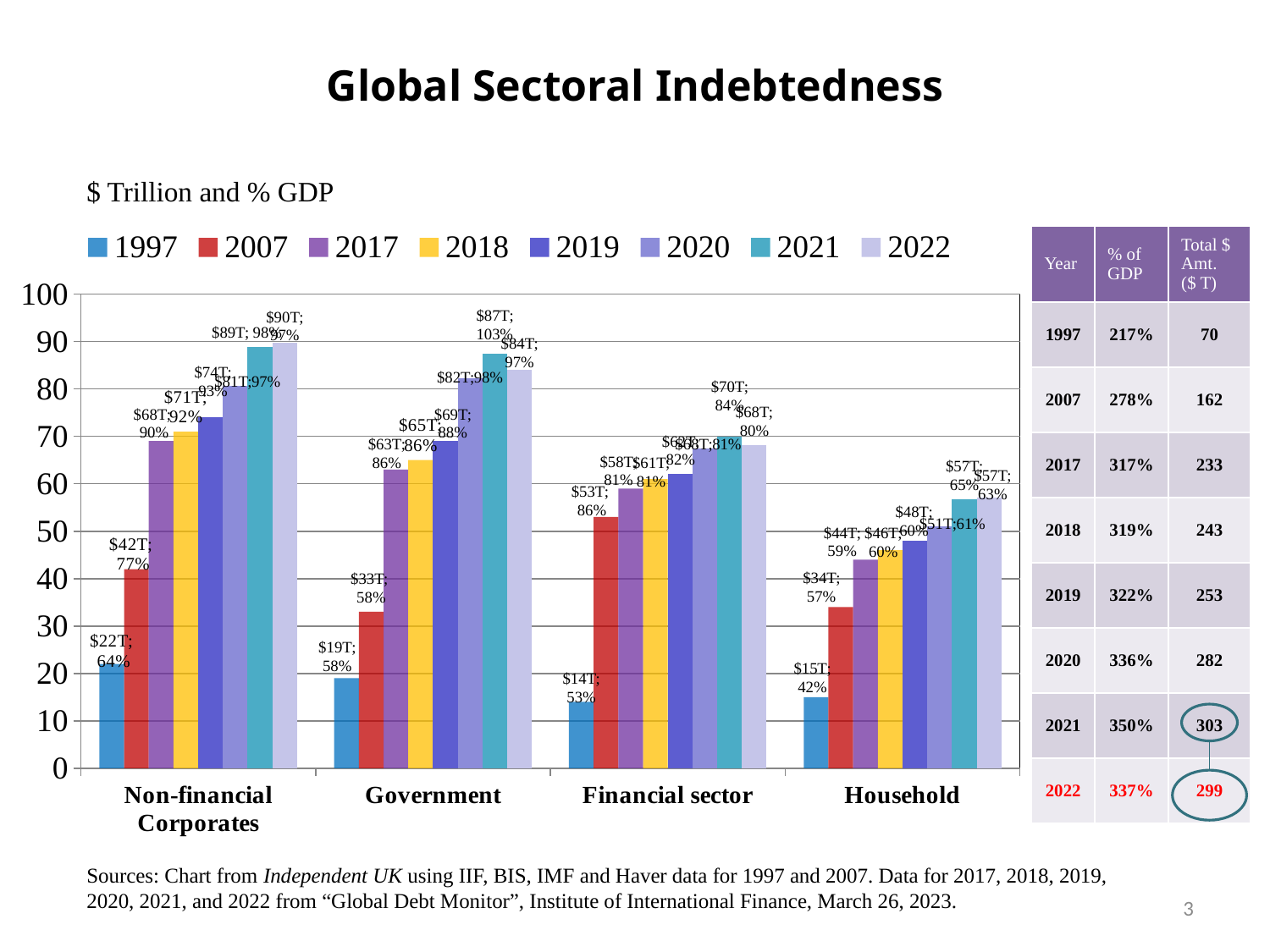
What is the data label for Government in 2007? $33T; 58% What kind of chart is shown on the slide? bar chart What is the data label for Non-financial Corporates in 1997? $22T; 64% Do the Household values rise or fall from 1997 to 2021? rise How many sector categories are shown on the x axis? 4 What is the title of the slide's chart? Global Sectoral Indebtedness What is the data label for Financial sector in 1997? $14T; 53% How many series does the chart legend list? 8 What is the data label for Household in 1997? $15T; 42% Which sector has the highest 2022 value? Non-financial Corporates What is the difference in $ trillion between Non-financial Corporates in 2007 ($42T) and in 1997 ($22T)? $20T Which sector has the lowest 1997 value? Financial sector